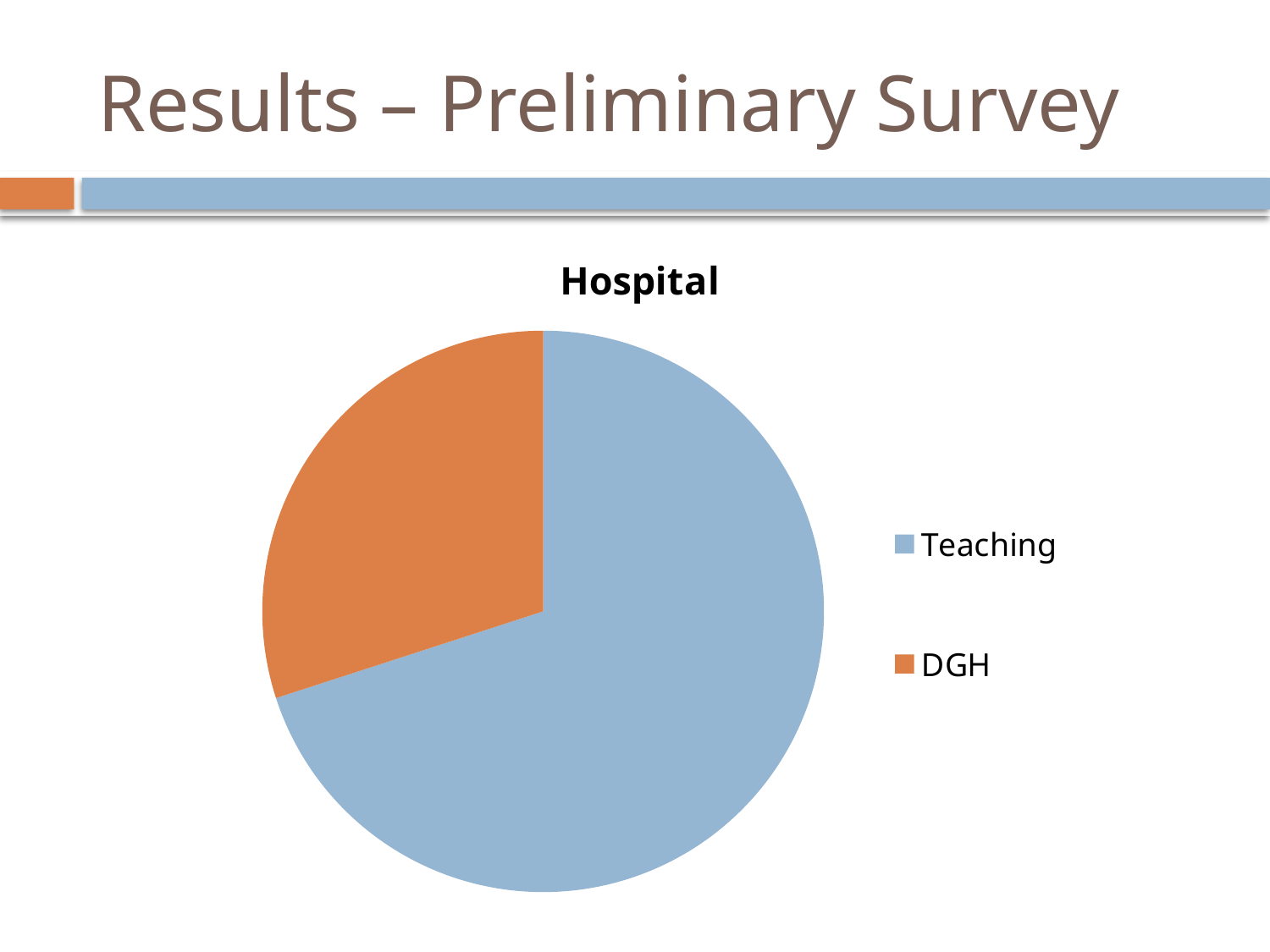
Is the DGH slice more or less than half of the pie? less Is the Teaching slice more or less than half of the pie? more Which slice is larger, Teaching or DGH? Teaching Which category has the smallest slice of the pie? DGH How many slices does the pie chart have? 2 What colour is the Teaching slice? blue What kind of chart is shown on the slide? pie chart What is the title of the chart? Hospital How many entries does the legend list? 2 Which category has the largest slice of the pie? Teaching